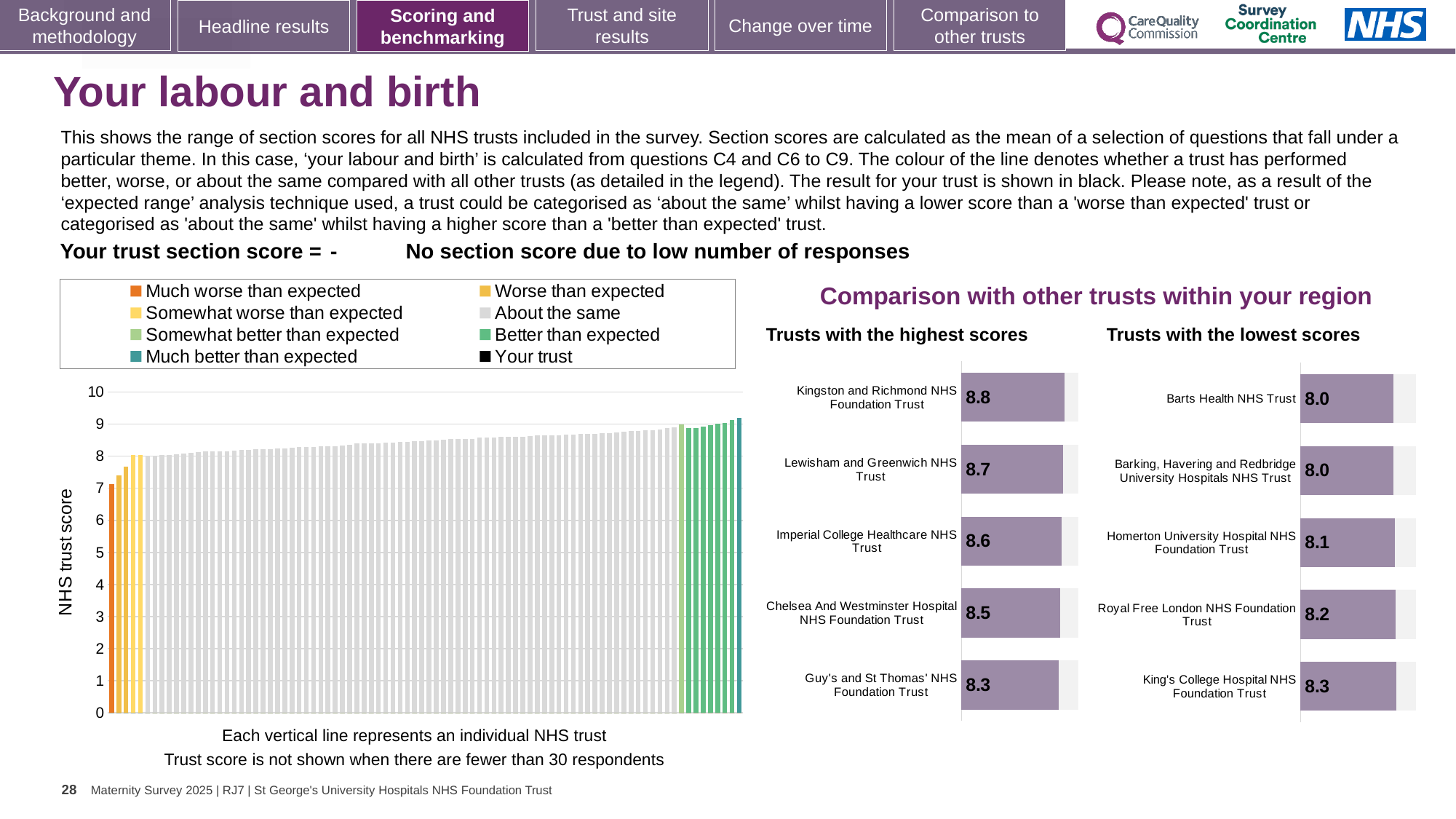
In the 'Trusts with the lowest scores' chart, what is the score for Homerton University Hospital NHS Foundation Trust? 8.1 In the NHS trust score chart on the left, do the bar values rise or fall from left to right? Rise In the 'Trusts with the highest scores' chart, which trust has the highest score? Kingston and Richmond NHS Foundation Trust How many entries does the legend of the NHS trust score chart list? 8 In the 'Trusts with the highest scores' chart, what is the score for Guy's and St Thomas' NHS Foundation Trust? 8.3 How many trusts are listed in the 'Trusts with the lowest scores' chart? 5 In the 'Trusts with the lowest scores' chart, what is the score for Royal Free London NHS Foundation Trust? 8.2 In the 'Trusts with the highest scores' chart, what is the score for Kingston and Richmond NHS Foundation Trust? 8.8 What kind of chart is the NHS trust score chart on the left of the slide? Bar chart In the 'Trusts with the lowest scores' chart, which trust has the highest score shown? King's College Hospital NHS Foundation Trust In the 'Trusts with the highest scores' chart, which has the larger score: Imperial College Healthcare NHS Trust or Chelsea And Westminster Hospital NHS Foundation Trust? Imperial College Healthcare NHS Trust In the 'Trusts with the highest scores' chart, what is the difference between the scores of Kingston and Richmond NHS Foundation Trust and Guy's and St Thomas' NHS Foundation Trust? 0.5